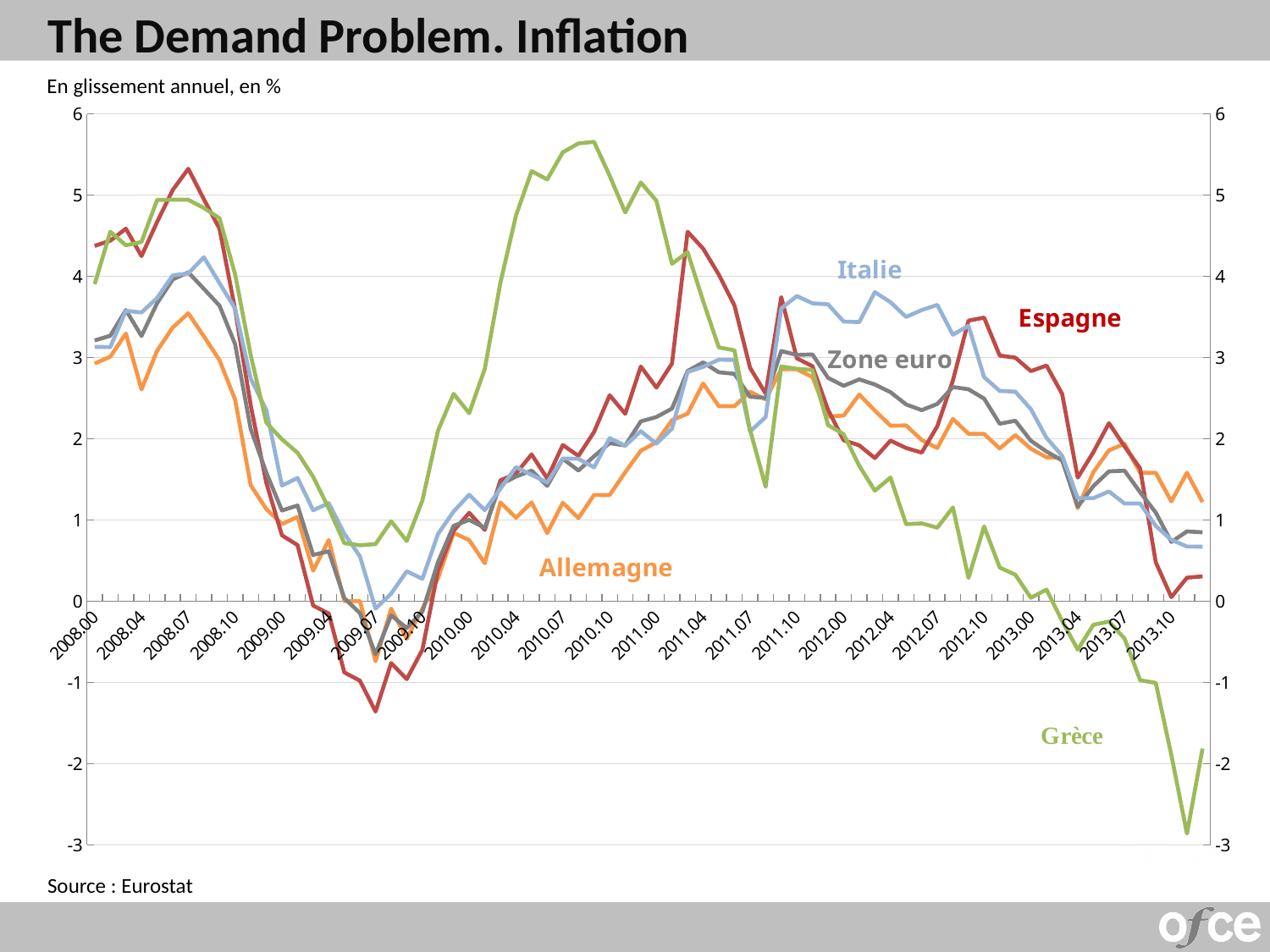
Is the value for Espagne at its 2008 peak greater or less than 5? greater How many country/region series are plotted on the chart? 5 Is the peak value for Grèce around 2010.07 greater or less than 5? greater What kind of chart is shown on the slide? Line chart Is the value for Grèce at the end of 2013 (its lowest point) greater or less than -2? less Which series reaches the lowest value anywhere on the chart? Grèce Does the Espagne series rise or fall between 2009.07 and 2011.04? Rise Does the Grèce series rise or fall between 2012.04 and 2013.10? Fall Which series reaches the highest value anywhere on the chart? Grèce What is the source cited for the chart data? Eurostat